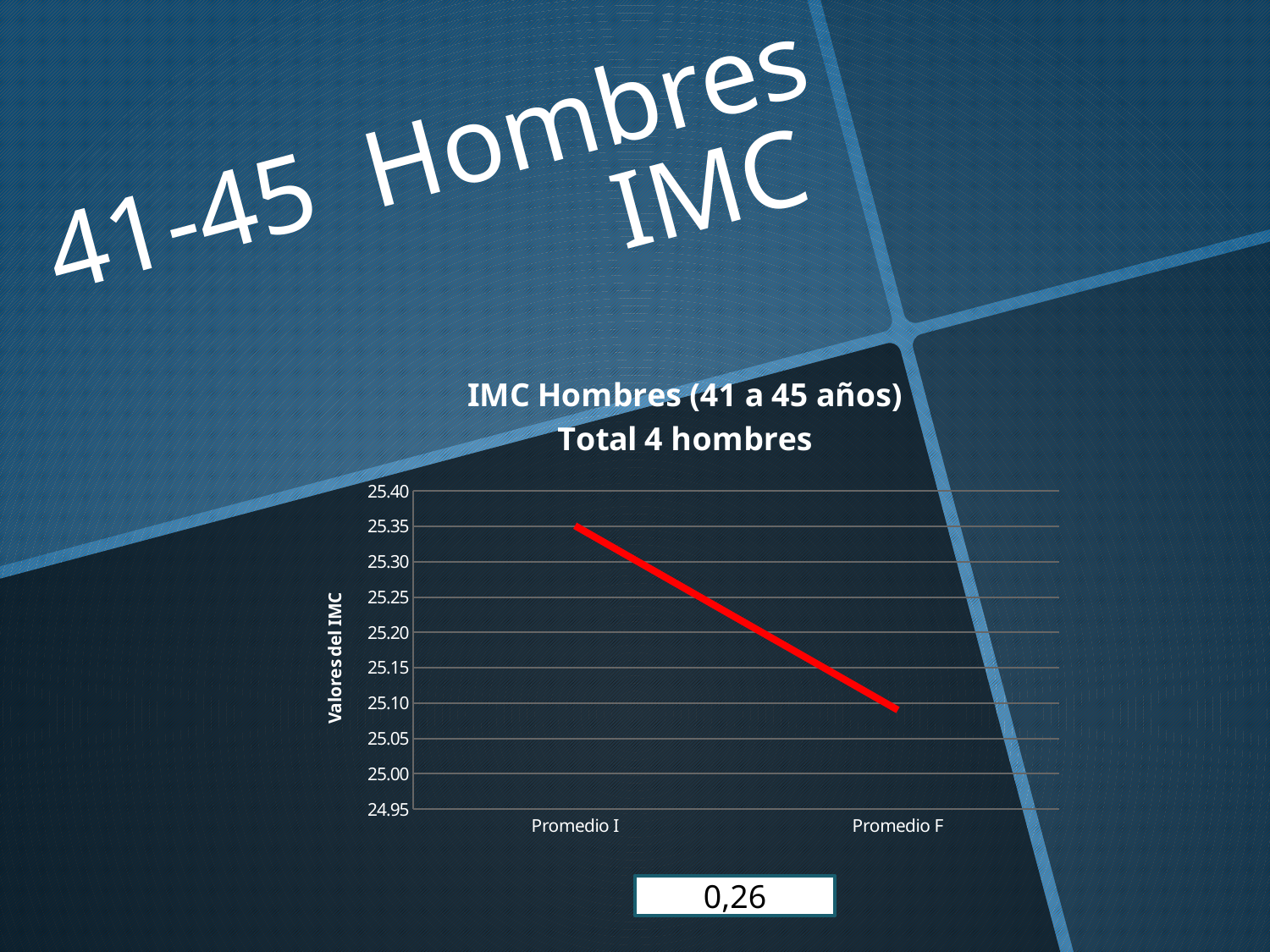
Do the values rise or fall from Promedio I to Promedio F? fall What is the label on the vertical axis of the chart? Valores del IMC Which is larger, the value for Promedio I or the value for Promedio F? Promedio I Is the value for Promedio F greater or less than 25.00? greater What is the title of the chart? IMC Hombres (41 a 45 años) Total 4 hombres Is the value for Promedio I greater or less than 25.30? greater Is the value for Promedio F greater or less than 25.20? less Which category has the lowest value in the chart? Promedio F What kind of chart is shown on the slide? line chart How many categories are plotted on the x axis of the chart? 2 Which category has the highest value in the chart? Promedio I